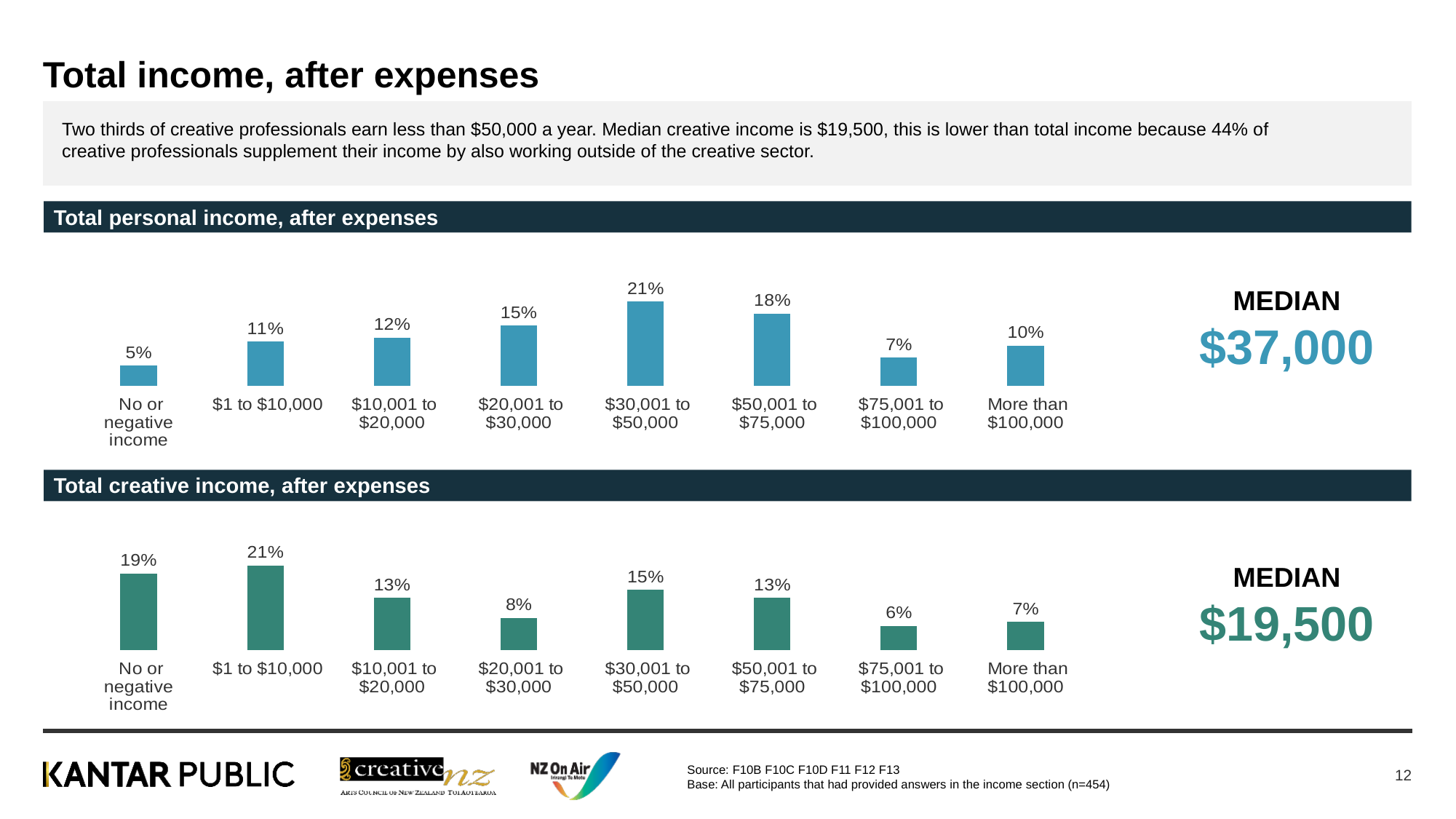
In the 'Total personal income, after expenses' chart, what is the difference between the values for $50,001 to $75,000 and $75,001 to $100,000? 11% What median value is shown next to the 'Total creative income, after expenses' chart? $19,500 What kind of chart is the 'Total personal income, after expenses' chart? Bar chart In the 'Total personal income, after expenses' chart, what is the value for $30,001 to $50,000? 21% In the 'Total personal income, after expenses' chart, which category has the lowest value? No or negative income In the 'Total creative income, after expenses' chart, what is the difference between the values for $1 to $10,000 and More than $100,000? 14% In the 'Total creative income, after expenses' chart, which is larger: the value for $10,001 to $20,000 or the value for $20,001 to $30,000? $10,001 to $20,000 In the 'Total creative income, after expenses' chart, what is the value for No or negative income? 19% In the 'Total creative income, after expenses' chart, which category has the lowest value? $75,001 to $100,000 In the 'Total personal income, after expenses' chart, which category has the highest value? $30,001 to $50,000 In the 'Total creative income, after expenses' chart, which category has the highest value? $1 to $10,000 How many categories are shown in the 'Total creative income, after expenses' chart? 8